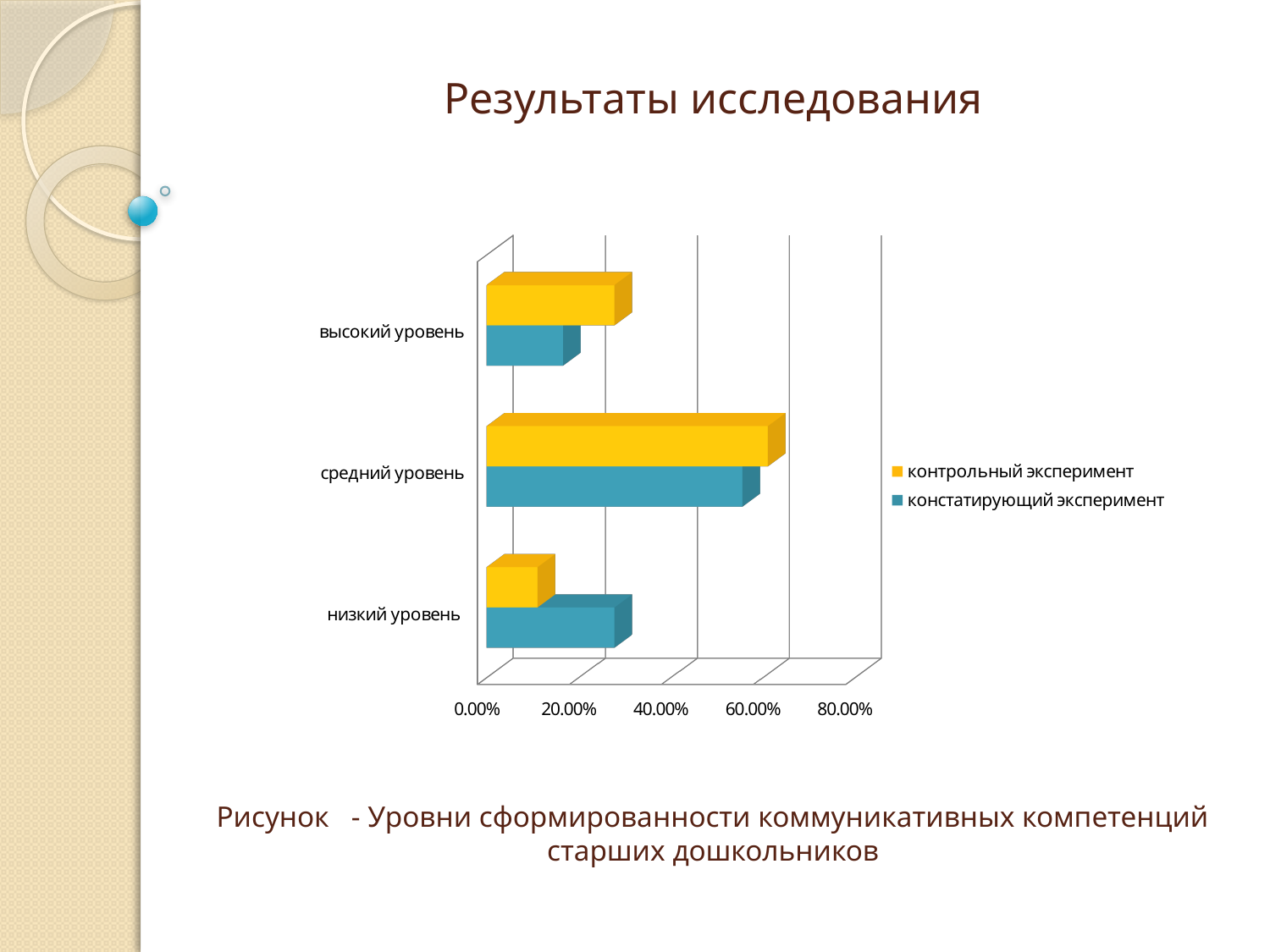
What kind of chart is shown on the slide? bar chart For низкий уровень, which series has the larger value? констатирующий эксперимент For высокий уровень, which series has the larger value? контрольный эксперимент Which category has the lowest value for контрольный эксперимент? низкий уровень How many series does the legend list? 2 How many categories (levels) are shown on the chart? 3 Which category has the lowest value for констатирующий эксперимент? высокий уровень Is the value for низкий уровень in контрольный эксперимент greater or less than 20.00%? less Is the value for высокий уровень in контрольный эксперимент greater or less than 20.00%? greater Which category has the highest value for контрольный эксперимент? средний уровень Is the value for средний уровень in констатирующий эксперимент greater or less than 40.00%? greater Which series is shown in yellow? контрольный эксперимент